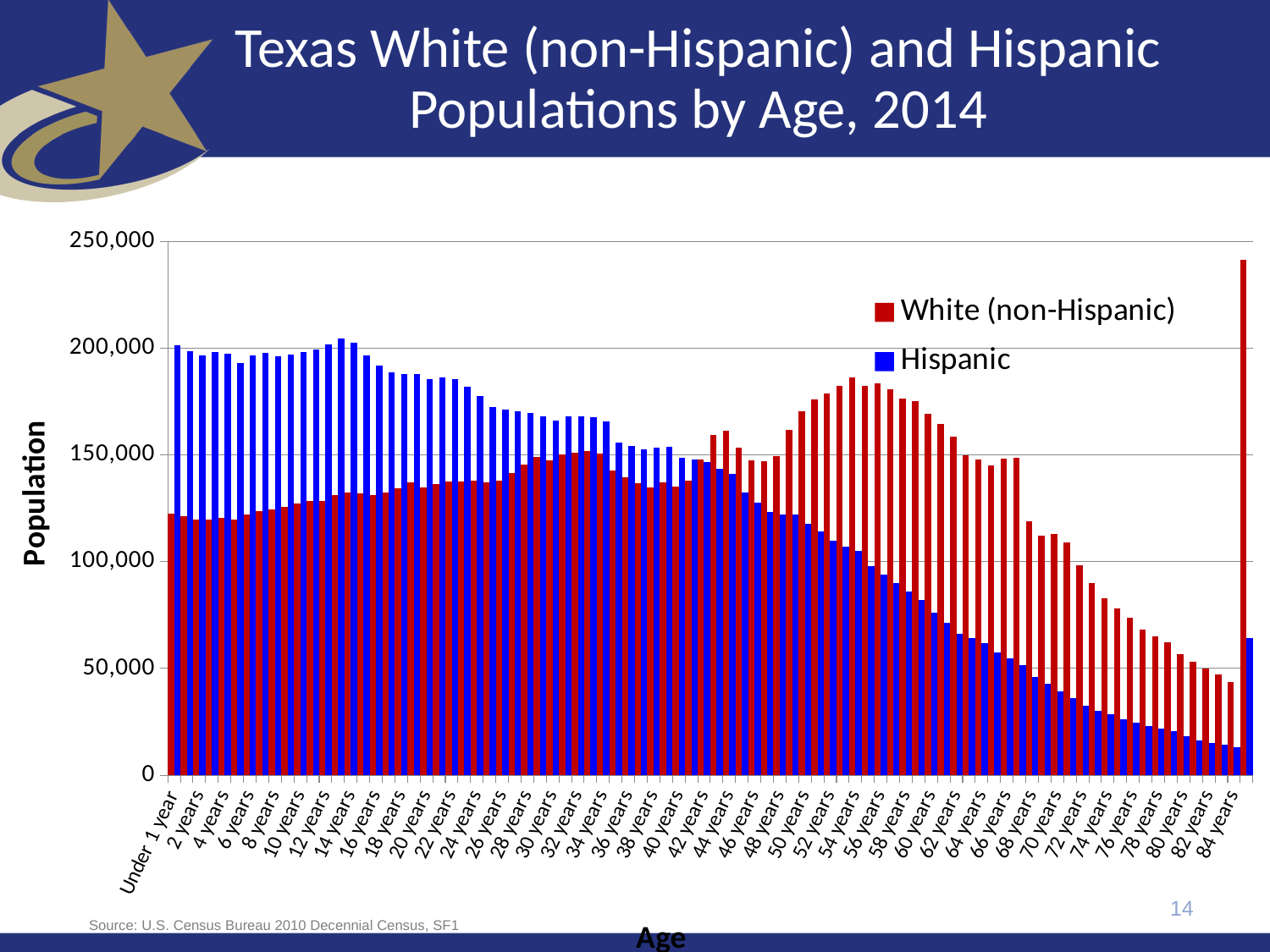
Is the Hispanic value for 60 years greater or less than 100,000? less Is the Hispanic value for 84 years greater or less than 50,000? less At 54 years, which series has the larger value, White (non-Hispanic) or Hispanic? White (non-Hispanic) What kind of chart is shown on the slide? bar chart Which two series are listed in the chart legend? White (non-Hispanic) and Hispanic How many series does the legend list? 2 Is the White (non-Hispanic) value for 2 years greater or less than 100,000? greater At 2 years, which series has the larger value, White (non-Hispanic) or Hispanic? Hispanic What is the label on the vertical axis of the chart? Population Do the Hispanic values generally rise or fall as age increases from 14 years to 84 years? fall